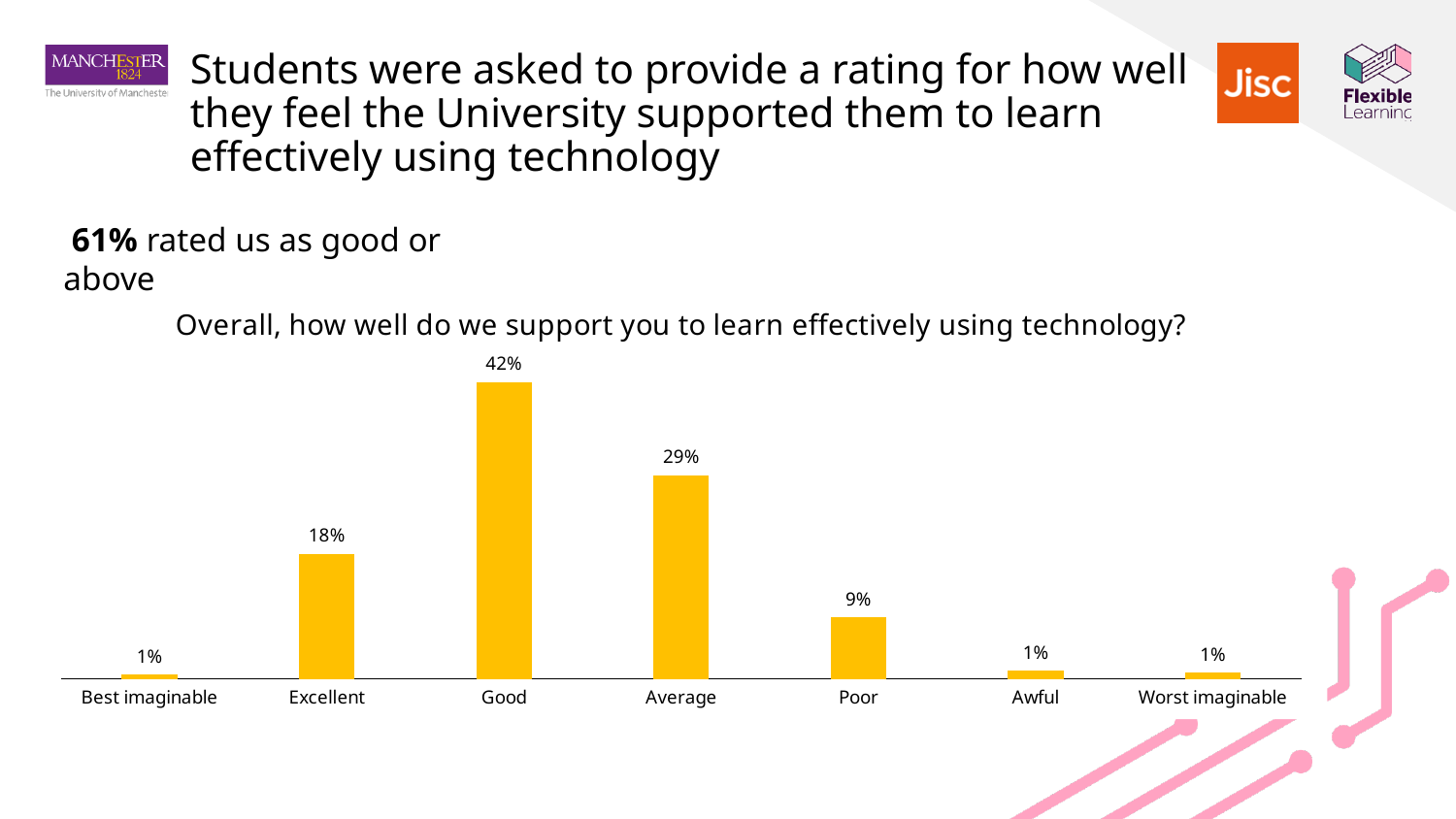
What is the title of the chart? Overall, how well do we support you to learn effectively using technology? What percentage of students rated the support as Poor? 9% Which is larger, the percentage for Excellent or the percentage for Average? Average What is the difference in percentage points between the Good and Average ratings? 13 Which rating category has the highest percentage? Good What percentage of students rated the support as Worst imaginable? 1% What is the difference in percentage points between the Excellent and Poor ratings? 9 What percentage of students rated the support as Good? 42% What percentage of students rated the support as Excellent? 18% What kind of chart is shown on the slide? Bar chart How many rating categories are shown on the x axis? 7 What percentage of students rated the support as Average? 29%